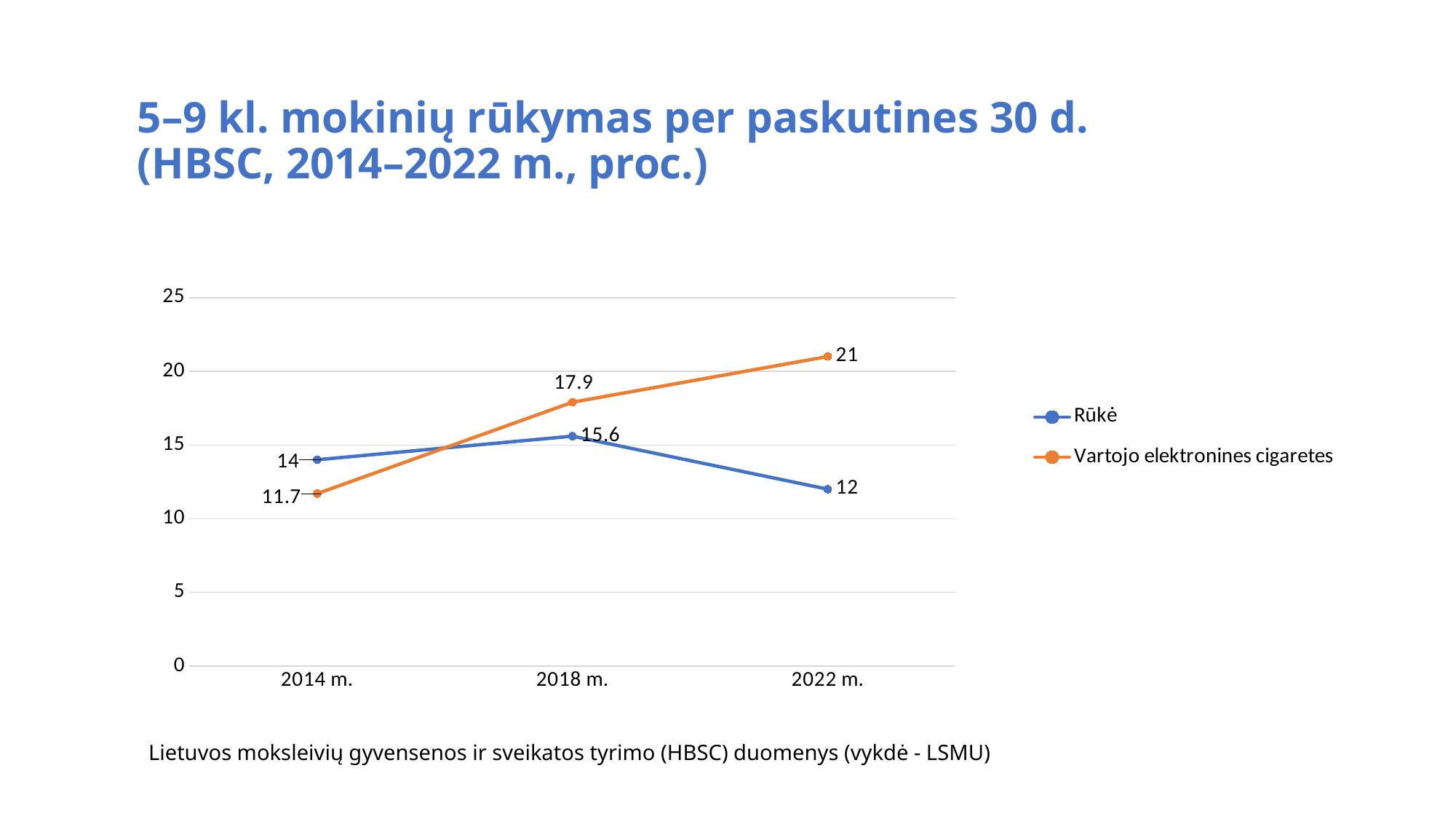
What is the value for Vartojo elektronines cigaretes in 2018 m.? 17.9 In which year is the Rūkė series highest? 2018 m. Does the Vartojo elektronines cigaretes series rise or fall from 2014 m. to 2022 m.? Rise What is the value for Vartojo elektronines cigaretes in 2022 m.? 21 What is the value for Rūkė in 2014 m.? 14 What kind of chart is shown on the slide? Line chart How many series does the legend list? 2 Which series has the larger value in 2014 m., Rūkė or Vartojo elektronines cigaretes? Rūkė What is the difference between Vartojo elektronines cigaretes and Rūkė in 2022 m.? 9 In which year is the Vartojo elektronines cigaretes series lowest? 2014 m. How many years are shown on the x axis? 3 What is the value for Rūkė in 2022 m.? 12